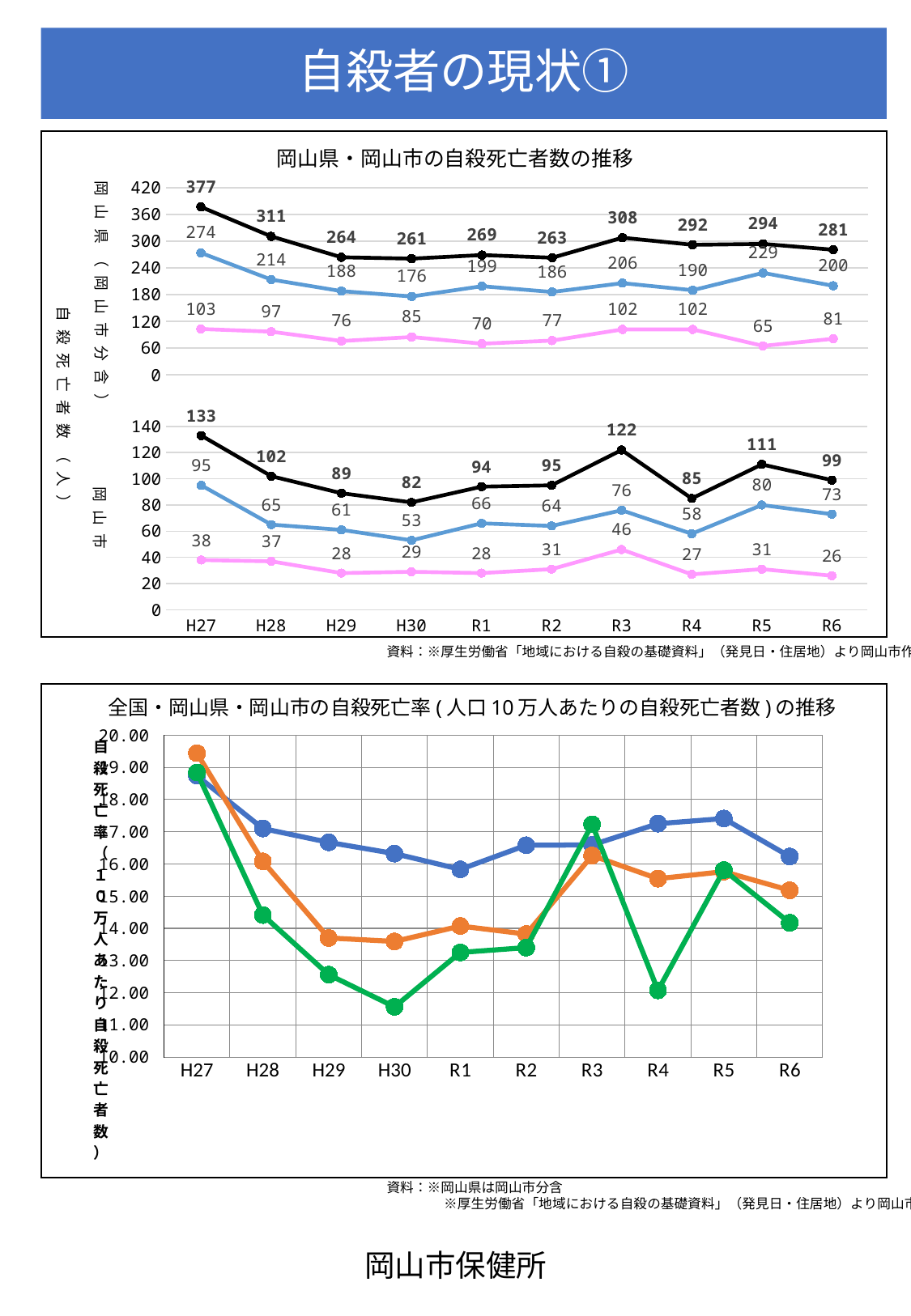
In the top chart (岡山県・岡山市の自殺死亡者数の推移), what is the bold value on the black line for H27 in the 岡山県 panel? 377 How many years are shown on the x axis of the top chart? 10 In the bottom chart, is the green line's value for H30 greater or less than 12.00? less In the top chart's 岡山市 panel, which is larger: the bold value for R4 or for R5? R5 In the bottom chart, is the blue line's value for R5 greater or less than 17.00? greater In the top chart's 岡山市 panel, which year has the highest bold value on the black line? H27 In the top chart's 岡山県 panel, does the black line rise or fall from H27 to H30? fall In the top chart's 岡山県 panel, what is the difference between the bold values for H27 and R6? 96 What kind of chart is the bottom chart (全国・岡山県・岡山市の自殺死亡率の推移)? line chart In the top chart, what is the bold value on the black line for R3 in the 岡山市 panel? 122 In the top chart's 岡山市 panel, what is the pink line's value for R6? 26 In the top chart's 岡山県 panel, which year has the lowest bold value on the black line? H30